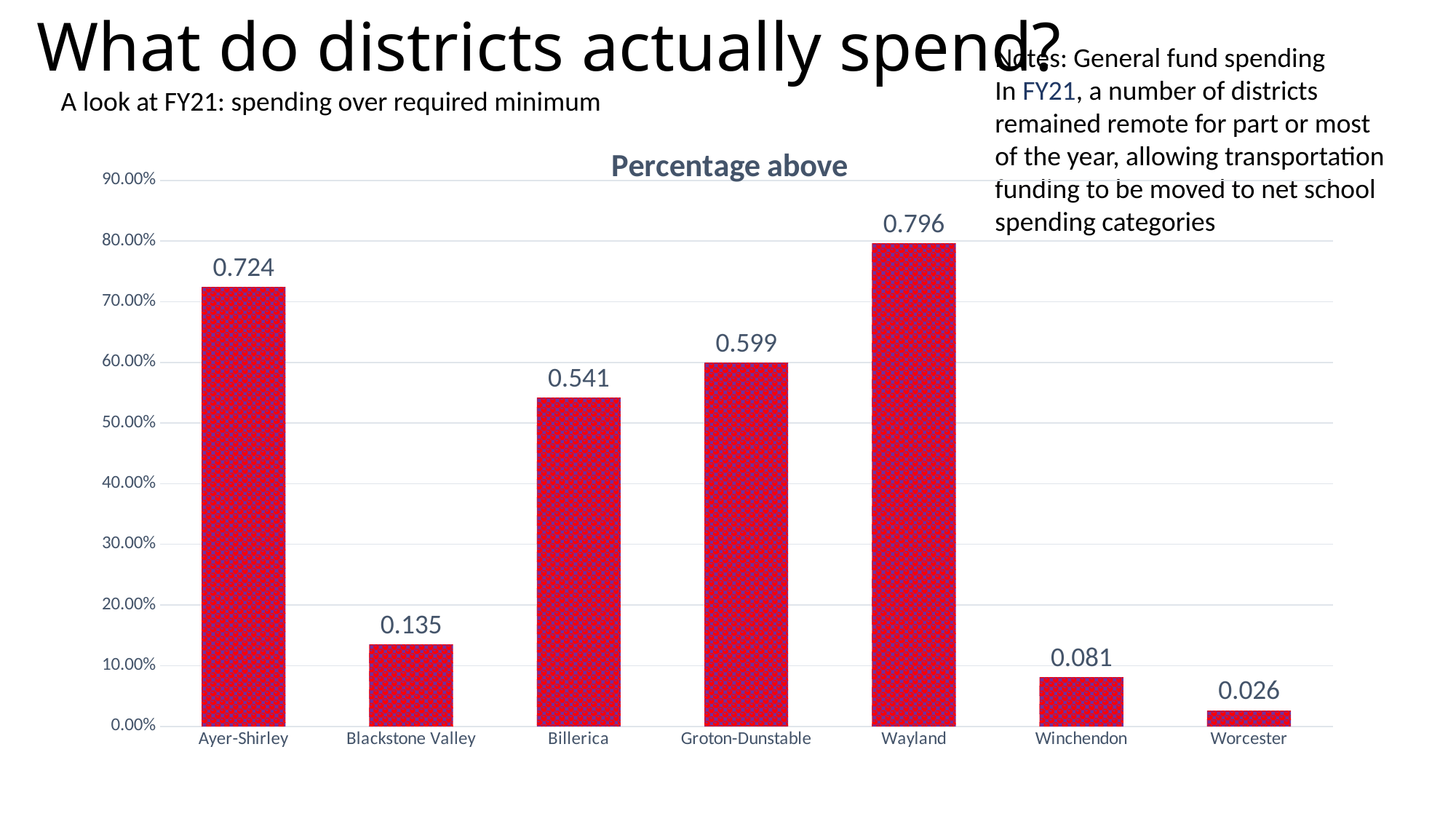
Is the value for Blackstone Valley greater or less than 20.00%? less What is the difference between the values for Wayland and Ayer-Shirley? 0.072 What is the value for Worcester? 0.026 Which district has the highest value? Wayland What kind of chart is shown on the slide? bar chart Which is larger, the value for Billerica or the value for Groton-Dunstable? Groton-Dunstable Which district has the lowest value? Worcester What is the difference between the values for Winchendon and Worcester? 0.055 How many districts are shown on the chart? 7 What is the value for Ayer-Shirley? 0.724 What is the value for Groton-Dunstable? 0.599 What is the title of the chart? Percentage above